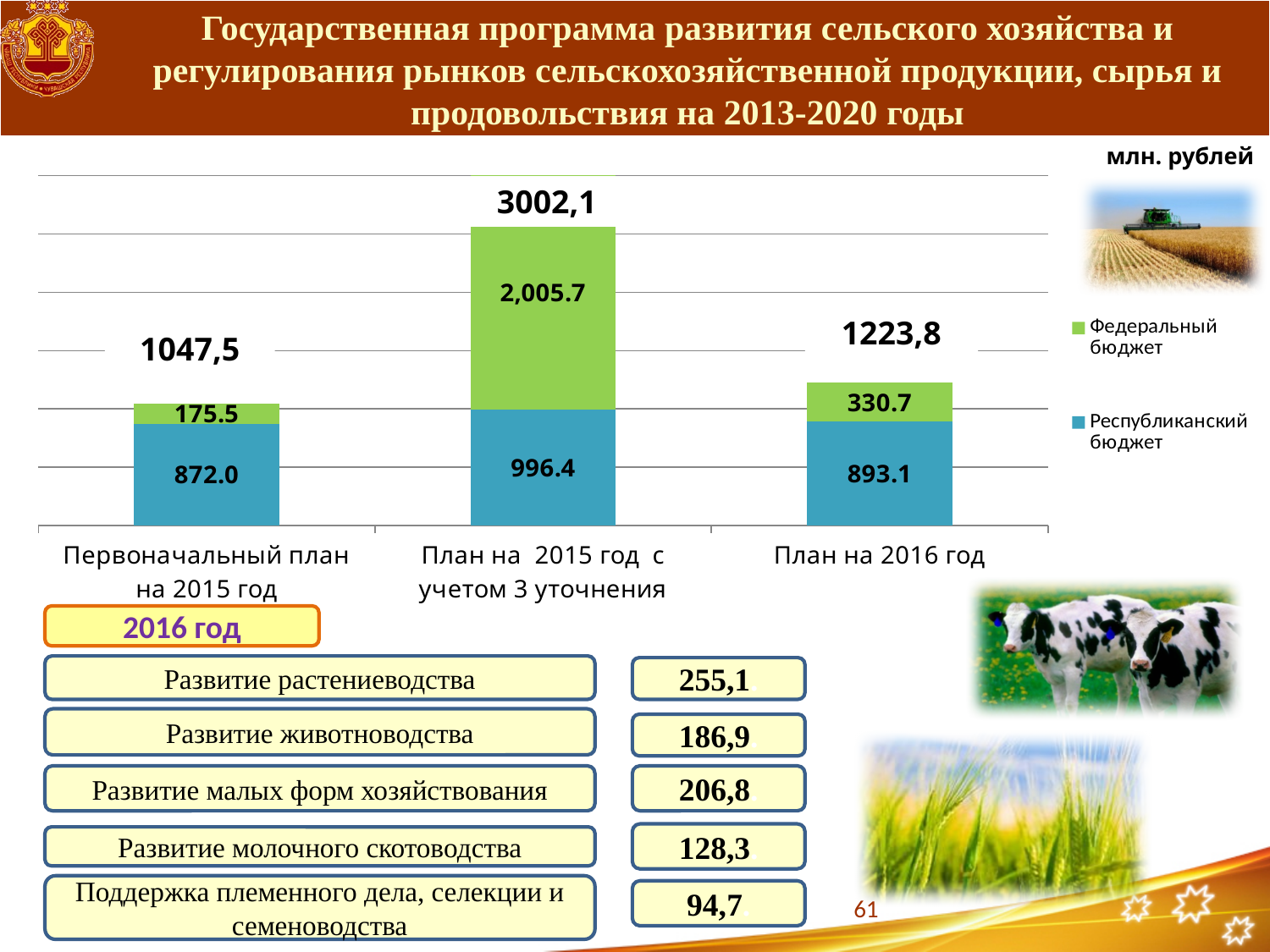
What is the total shown above the bar for План на 2016 год? 1223,8 What is the total shown above the bar for План на 2015 год с учетом 3 уточнения? 3002,1 Which is larger: Республиканский бюджет for План на 2016 год or for Первоначальный план на 2015 год? План на 2016 год What is the value of Федеральный бюджет for План на 2015 год с учетом 3 уточнения? 2,005.7 How many series does the chart legend list? 2 Which category has the highest total value? План на 2015 год с учетом 3 уточнения Which category has the lowest Федеральный бюджет value? Первоначальный план на 2015 год What is the value of Федеральный бюджет for План на 2016 год? 330.7 How many categories are shown on the x axis of the chart? 3 What is the difference between the Федеральный бюджет values for План на 2016 год and Первоначальный план на 2015 год? 155.2 What is the value of Республиканский бюджет for Первоначальный план на 2015 год? 872.0 What type of chart is shown on the slide? stacked bar chart